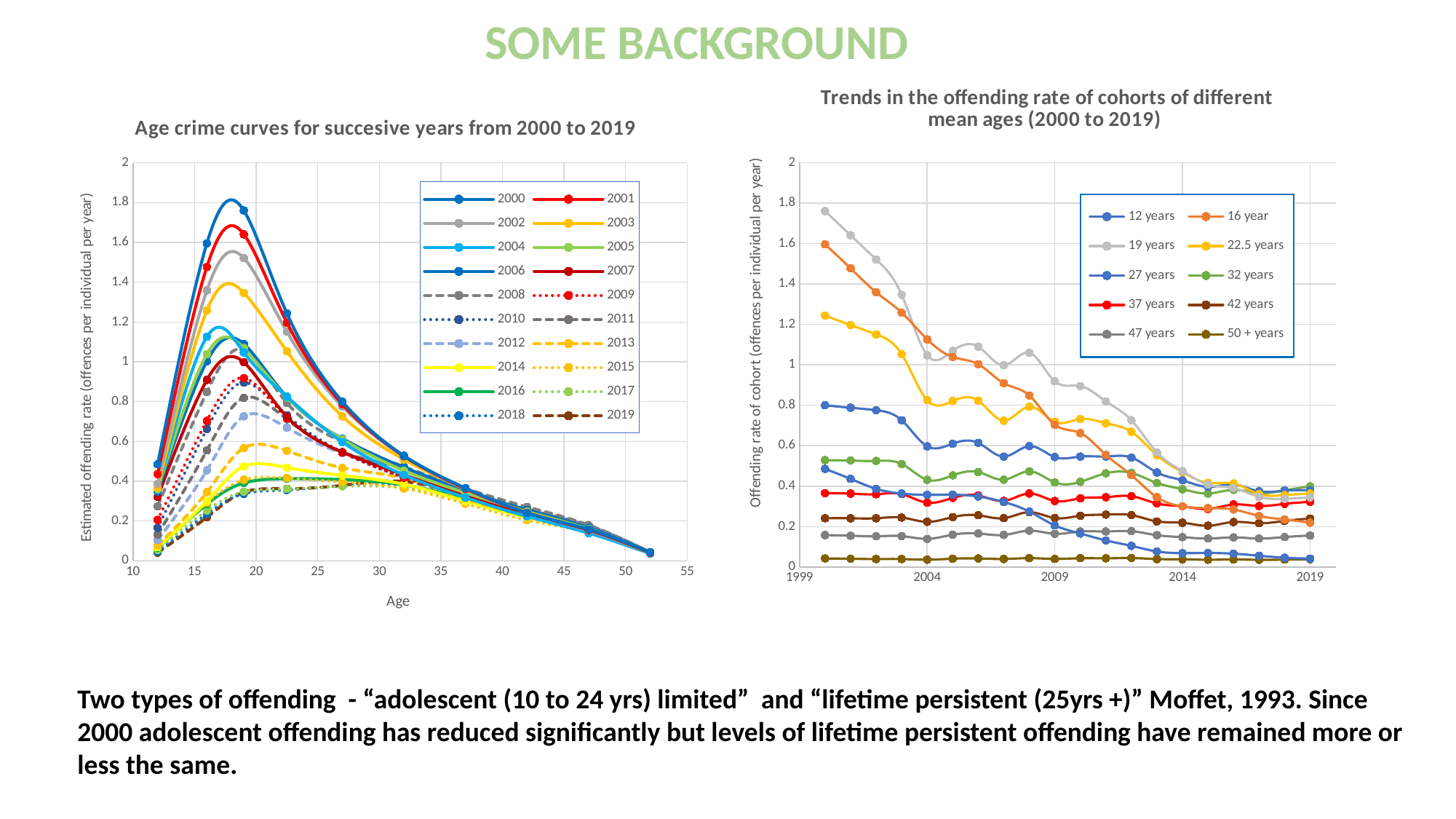
In the left chart, is the peak value of the 2000 curve greater or less than 1.6? greater How many series does the legend of the left chart list? 20 What type of chart is the right chart, 'Trends in the offending rate of cohorts of different mean ages (2000 to 2019)'? line chart What type of chart is the left chart, 'Age crime curves for succesive years from 2000 to 2019'? line chart In the right chart, which cohort has the highest offending rate at the start of the period (around 2000)? 19 years In the right chart, does the offending rate of the 12 years cohort rise or fall from 2000 to 2019? fall How many series does the legend of the right chart list? 10 In the left chart, which year's curve reaches the highest peak? 2000 What is the x-axis label of the left chart? Age In the right chart, at the start of the period, which is larger: the value for the 16 year cohort or the 22.5 years cohort? 16 year In the right chart, which cohort has the lowest offending rate throughout the period? 50 + years In the right chart, is the value for the 19 years cohort at the start of the period greater or less than 1.6? greater